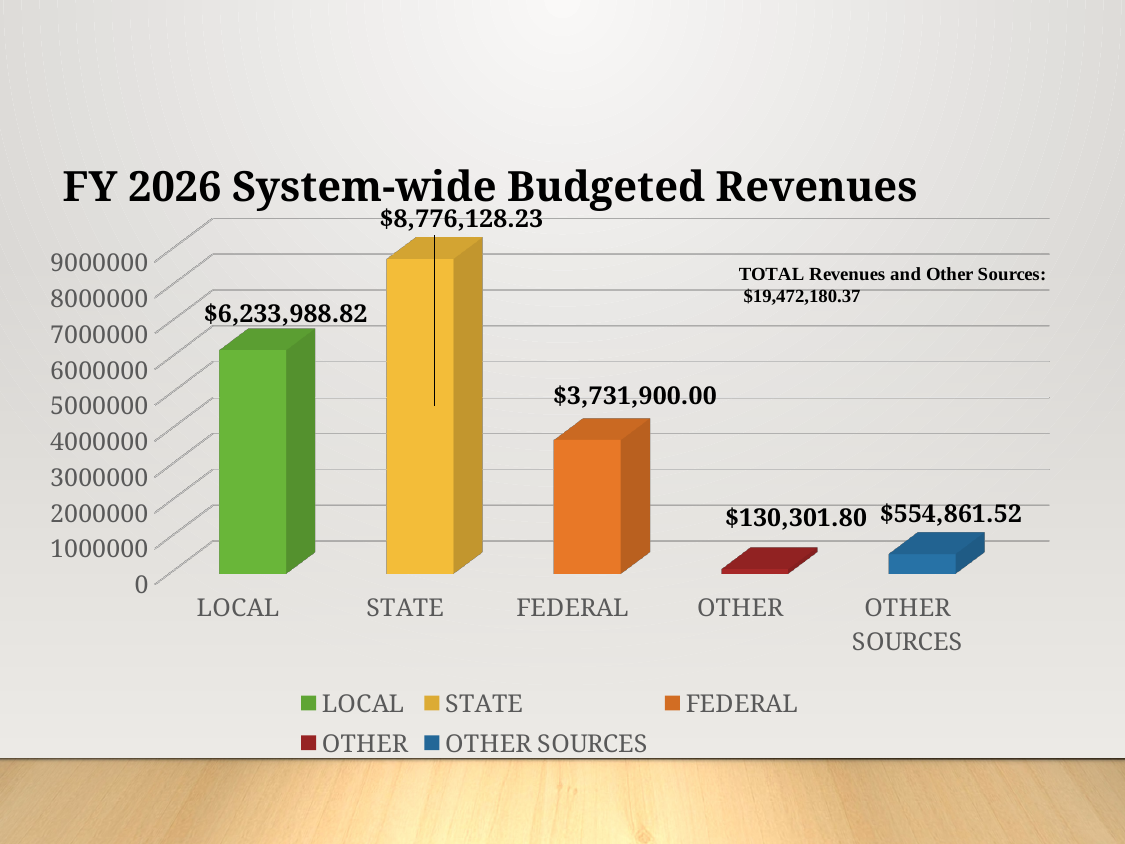
Which category has the lowest budgeted revenue? OTHER What is the difference between the STATE and LOCAL budgeted revenues? $2,542,139.41 What is the budgeted revenue for STATE? $8,776,128.23 What is the title of the chart? FY 2026 System-wide Budgeted Revenues What is the budgeted revenue for FEDERAL? $3,731,900.00 Which category has the highest budgeted revenue? STATE How many categories are shown in the chart? 5 What is the difference between the OTHER SOURCES and OTHER budgeted revenues? $424,559.72 What kind of chart is shown on the slide? Bar chart Which is larger, the budgeted revenue for LOCAL or for FEDERAL? LOCAL What is the budgeted revenue for LOCAL? $6,233,988.82 What is the budgeted revenue for OTHER SOURCES? $554,861.52